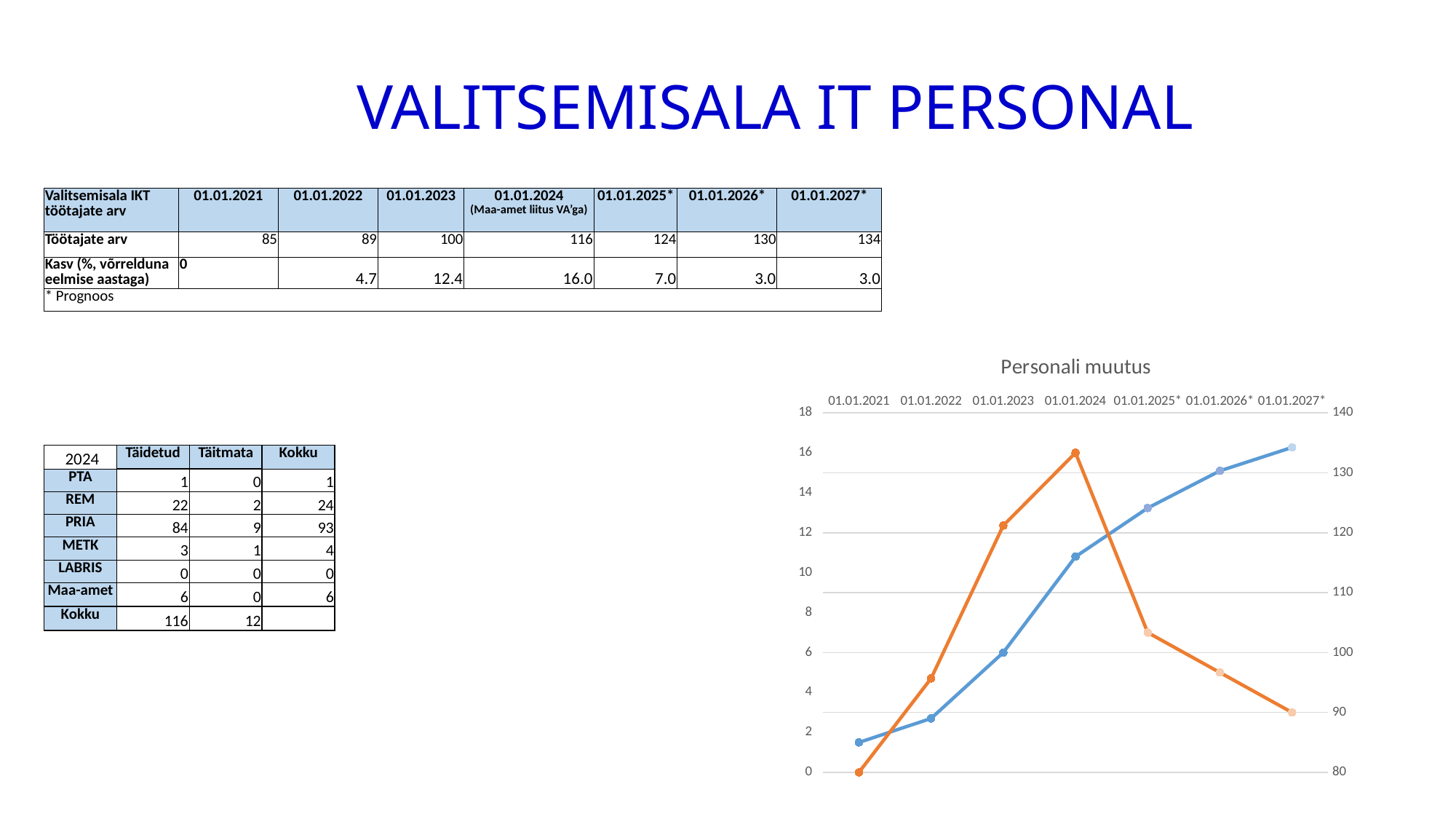
In the 'Personali muutus' chart, what value on the left axis does the orange line reach at 01.01.2024? 16 In the 'Personali muutus' chart, at which date is the orange line at its lowest point? 01.01.2021 In the 'Personali muutus' chart, does the blue line rise or fall from 01.01.2021 to 01.01.2027*? rise In the 'Personali muutus' chart, is the orange line's value at 01.01.2025* greater or less than 6 on the left axis? greater In the 'Personali muutus' chart, what value on the left axis does the orange line have at 01.01.2021? 0 In the 'Personali muutus' chart, is the orange line higher at 01.01.2023 or at 01.01.2026*? 01.01.2023 In the 'Personali muutus' chart, at which date does the orange line reach its highest point? 01.01.2024 How many dates are shown along the x axis of the 'Personali muutus' chart? 7 How many lines are plotted in the 'Personali muutus' chart? 2 What kind of chart is 'Personali muutus'? line chart In the 'Personali muutus' chart, is the blue line's value at 01.01.2021 greater or less than 90 on the right axis? less What is the title of the chart on the slide? Personali muutus